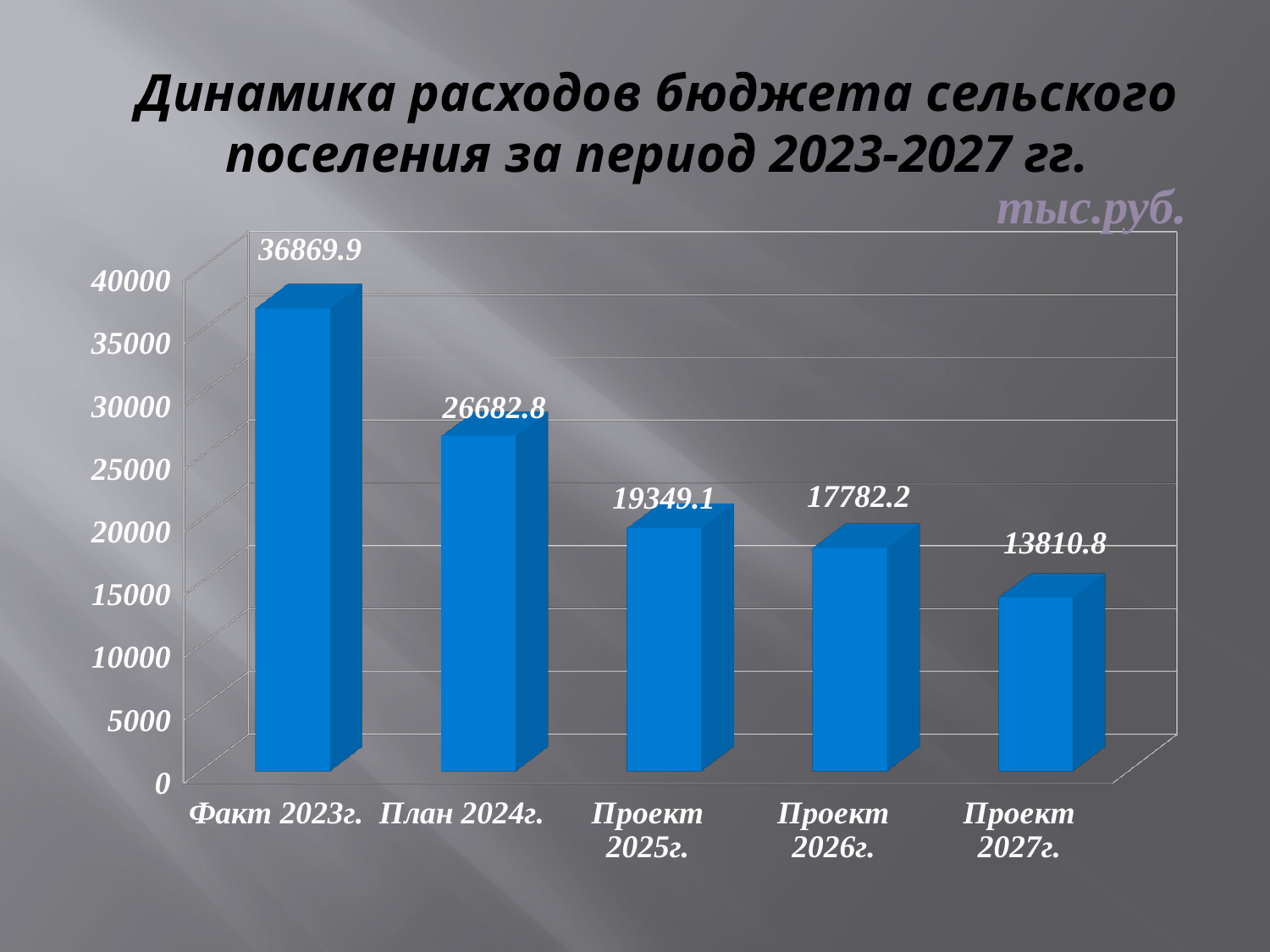
Which category has the lowest value? Проект 2027г. Do the values rise or fall from left to right along the x axis? Fall What kind of chart is shown on the slide? Bar chart What is the value for Проект 2025г.? 19349.1 Which is larger, the value for Проект 2025г. or Проект 2026г.? Проект 2025г. What is the difference between the values for Проект 2026г. and Проект 2027г.? 3971.4 Which category has the highest value? Факт 2023г. How many categories are shown on the x axis? 5 What is the value for План 2024г.? 26682.8 What is the value for Факт 2023г.? 36869.9 What is the value for Проект 2027г.? 13810.8 What is the difference between the values for Факт 2023г. and План 2024г.? 10187.1